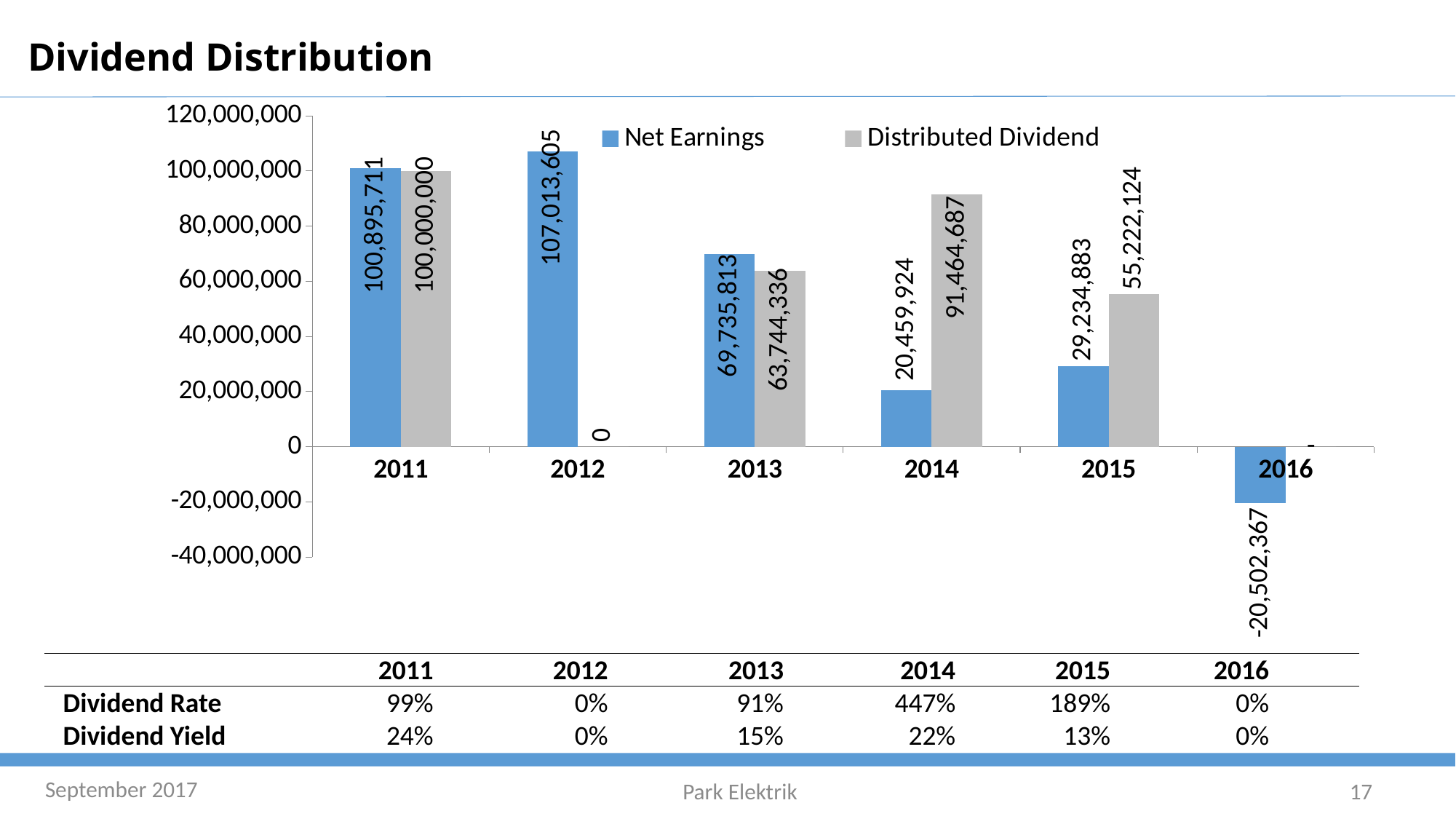
What was Net Earnings in 2012? 107,013,605 How many series does the legend list? 2 Which year had the highest Distributed Dividend? 2011 What was the Distributed Dividend in 2012? 0 What was Net Earnings in 2016? -20,502,367 Which year had the lowest Net Earnings? 2016 What kind of chart is shown on the slide? Bar chart How many years are shown on the x axis of the chart? 6 What is the difference between Net Earnings and Distributed Dividend in 2013? 5,991,477 What was the Distributed Dividend in 2014? 91,464,687 In 2015, which was larger: Net Earnings or Distributed Dividend? Distributed Dividend Which year had the highest Net Earnings? 2012